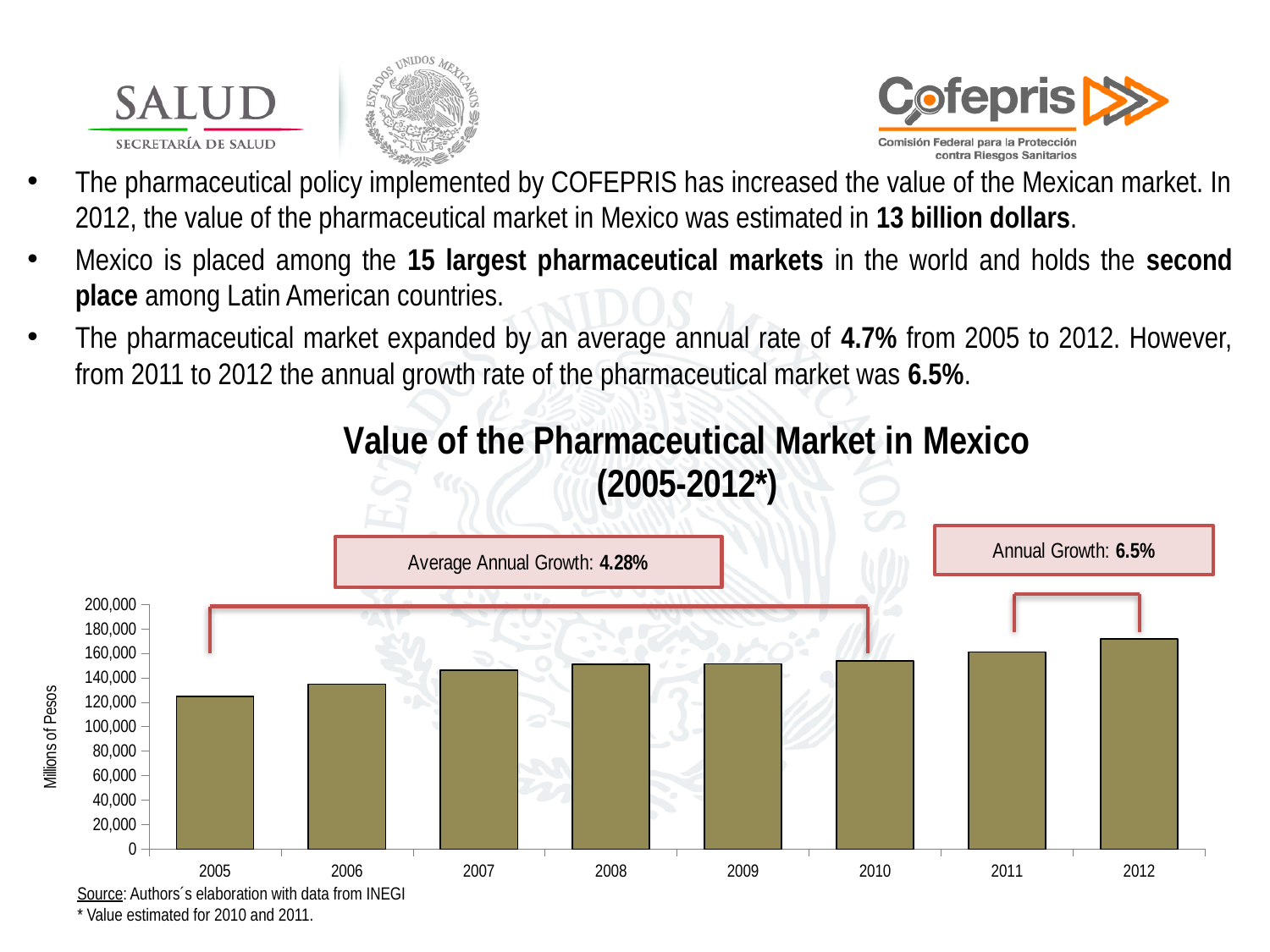
Is the value for 2011 greater or less than 140,000? greater Is the value for 2006 greater or less than 120,000? greater Which year has the highest value of the pharmaceutical market in the chart? 2012 Which is larger, the value for 2008 or the value for 2005? 2008 Is the value for 2005 greater or less than 140,000? less Which year has the lowest value of the pharmaceutical market in the chart? 2005 What unit is shown on the y axis label of the chart? Millions of Pesos How many years are plotted on the x axis of the chart? 8 What is the title of the chart? Value of the Pharmaceutical Market in Mexico (2005-2012*) Do the values rise or fall from 2005 to 2012 along the x axis? rise What kind of chart is shown on the slide? Bar chart